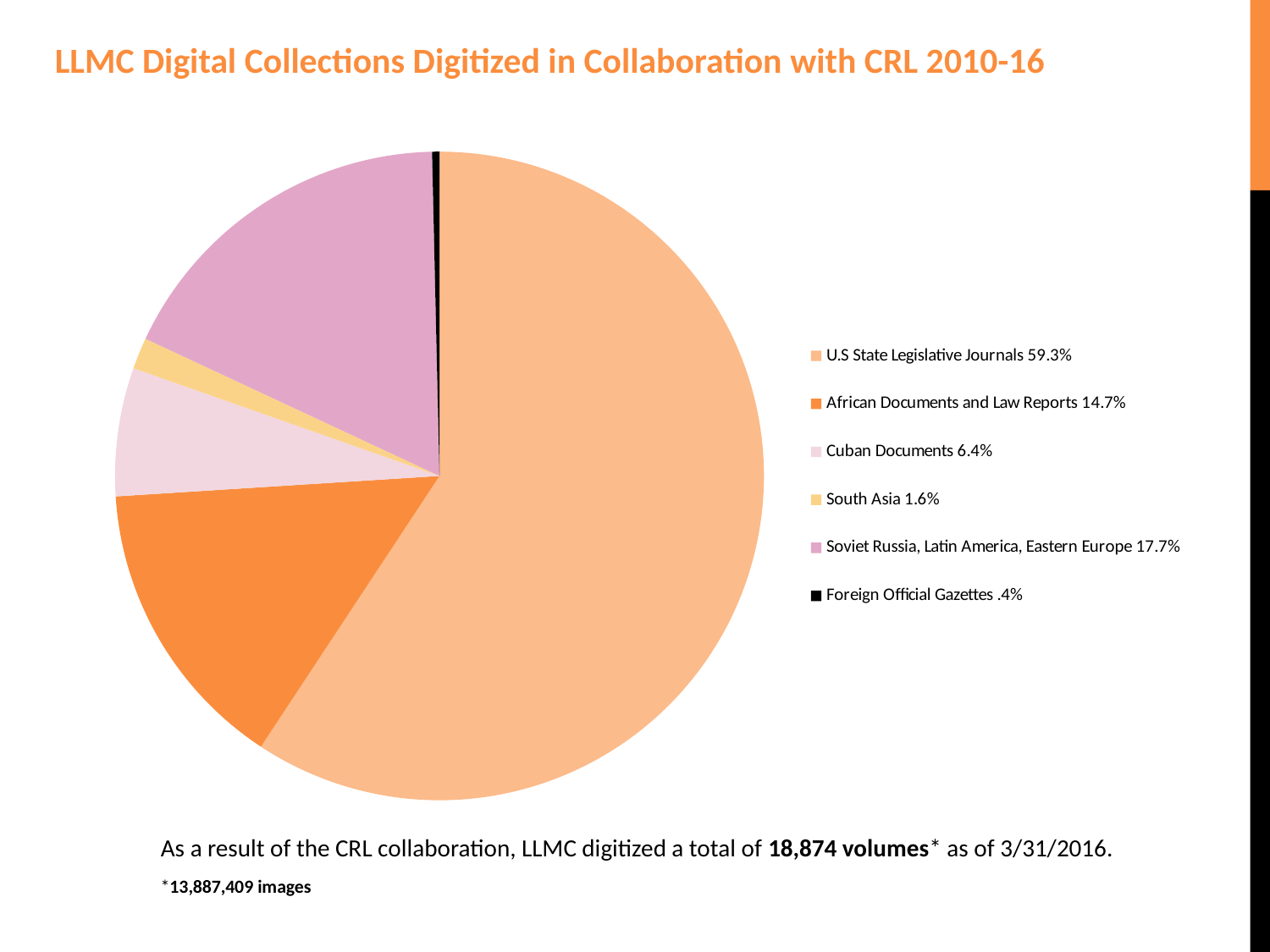
What share of the pie is South Asia? 1.6% What share of the pie is African Documents and Law Reports? 14.7% What kind of chart is shown on the slide? pie chart Which category has the smallest slice of the pie? Foreign Official Gazettes What share of the pie is U.S State Legislative Journals? 59.3% What is the title of the slide containing the pie chart? LLMC Digital Collections Digitized in Collaboration with CRL 2010-16 How many slices does the pie chart have? 6 Which category has the largest slice of the pie? U.S State Legislative Journals Which is larger: the share for African Documents and Law Reports or the share for Soviet Russia, Latin America, Eastern Europe? Soviet Russia, Latin America, Eastern Europe What is the difference in percentage points between U.S State Legislative Journals and African Documents and Law Reports? 44.6